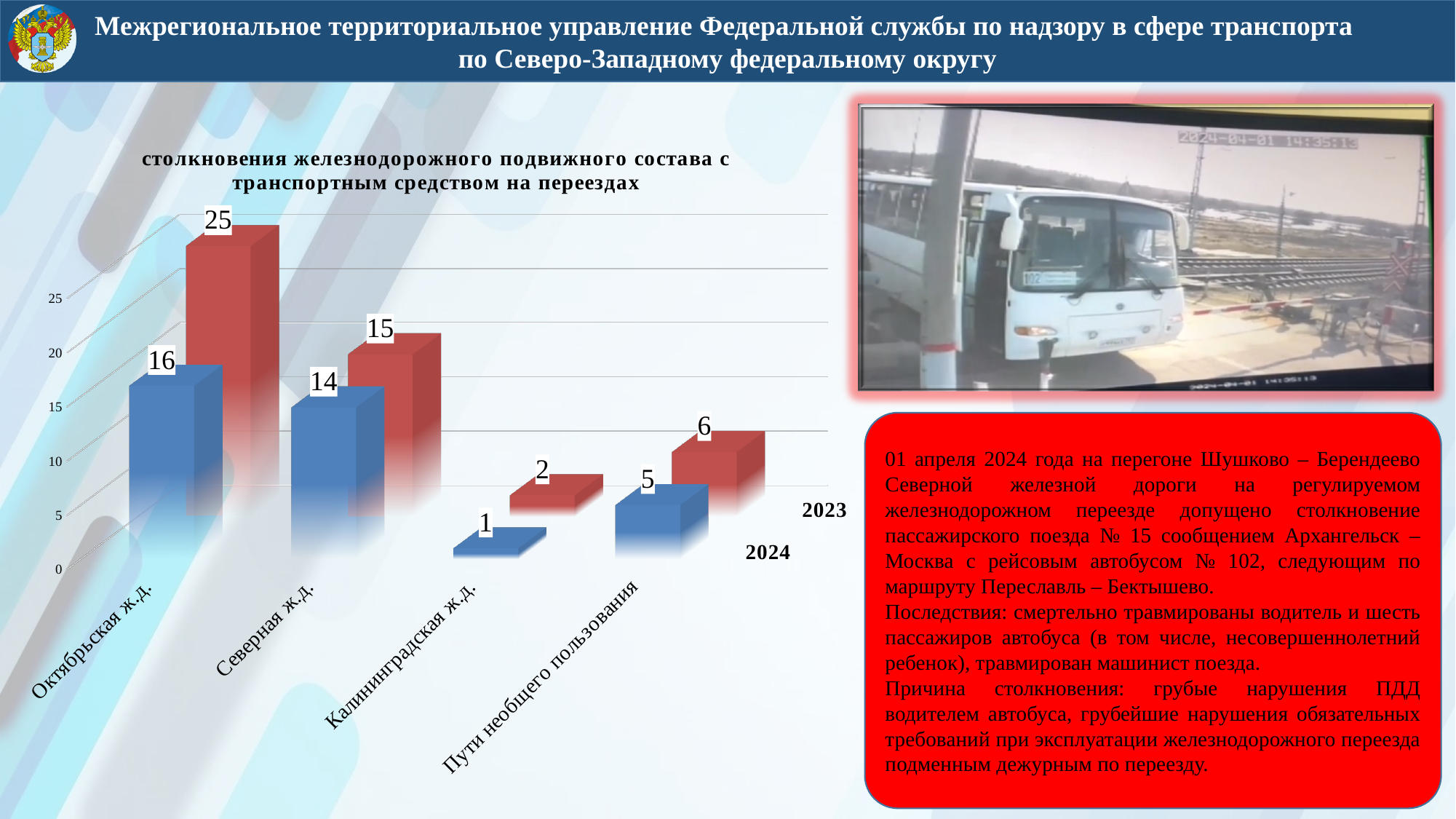
What is the value for Октябрьская ж.д. in 2023? 25 Which category has the highest value in 2023? Октябрьская ж.д. Which is larger for Северная ж.д.: the 2023 value or the 2024 value? 2023 What is the difference between the 2023 and 2024 values for Октябрьская ж.д.? 9 How many data series (years) does the chart show? 2 How many categories are shown on the x axis of the chart? 4 What type of chart is shown on the slide? bar chart What is the value for Северная ж.д. in 2024? 14 What is the value for Калининградская ж.д. in 2023? 2 Which category has the lowest value in 2024? Калининградская ж.д. What is the value for Октябрьская ж.д. in 2024? 16 What is the value for Пути необщего пользования in 2024? 5